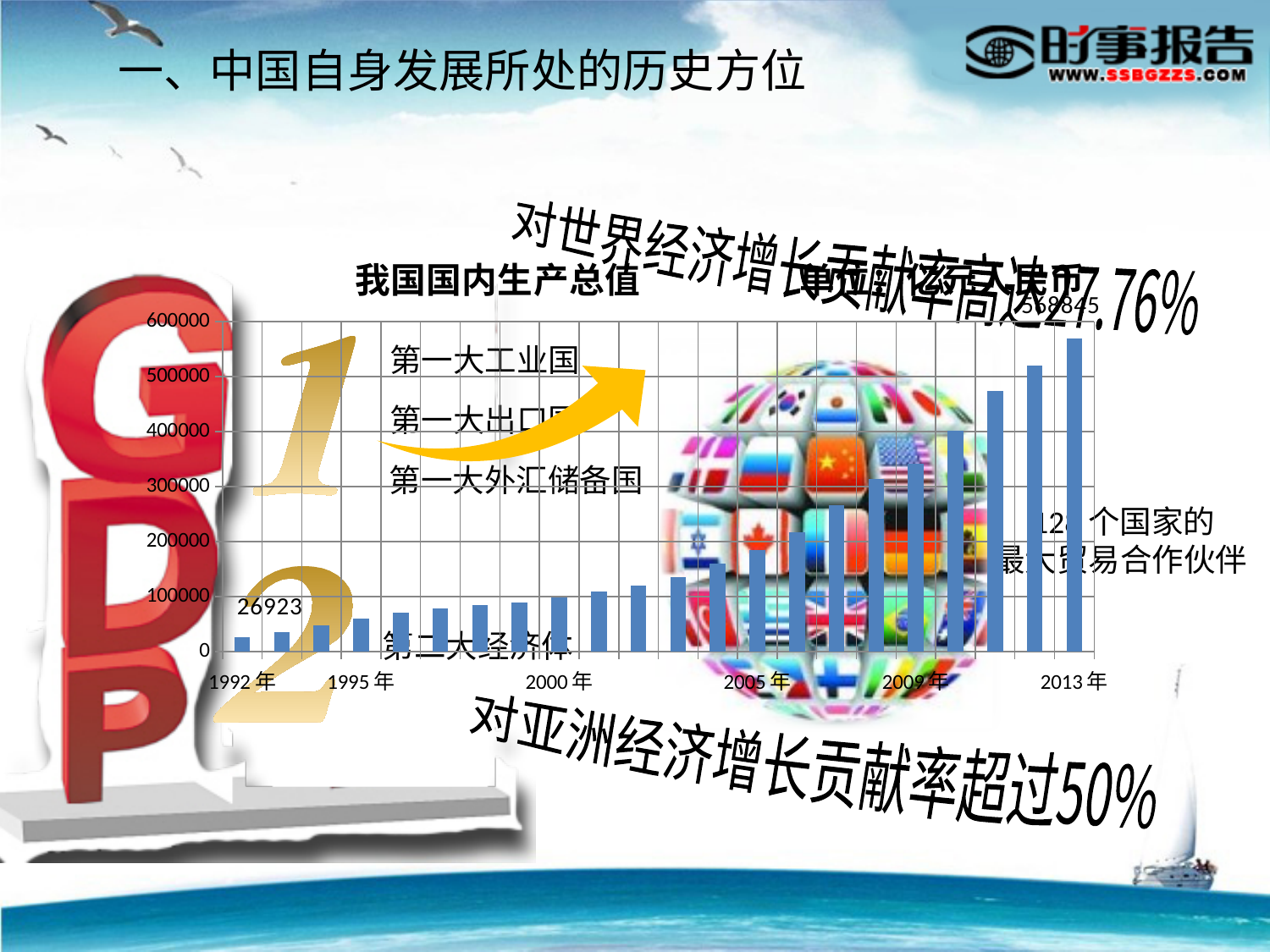
Is the value for 2009年 in the 我国国内生产总值 chart greater or less than 300000? greater Which year has the lowest bar in the 我国国内生产总值 chart? 1992年 What is the highest value labelled on the vertical axis of the 我国国内生产总值 chart? 600000 Is the value for 2000年 in the 我国国内生产总值 chart greater or less than 200000? less Which year has the highest bar in the 我国国内生产总值 chart? 2013年 How many bars are plotted in the 我国国内生产总值 chart? 22 In the 我国国内生产总值 chart, which is larger, the value for 2013年 or the value for 1992年? 2013年 What is the title of the bar chart on the slide? 我国国内生产总值 Is the value for 2013年 in the 我国国内生产总值 chart greater or less than 500000? greater What kind of chart is used to show 我国国内生产总值? bar chart Do the values in the 我国国内生产总值 chart rise or fall from 1992年 to 2013年? rise What is the value shown for 1992年 in the 我国国内生产总值 chart? 26923